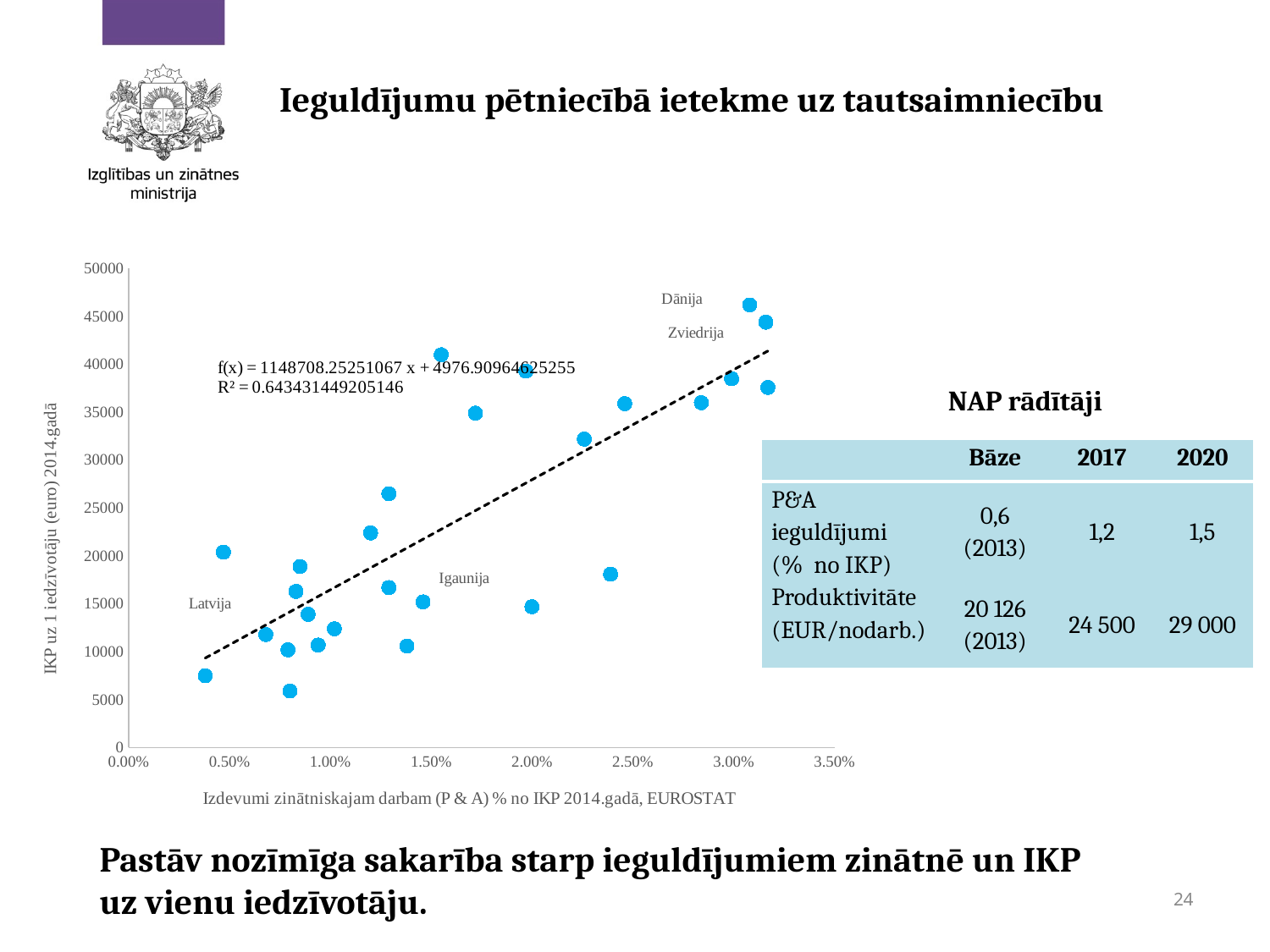
What R² value is printed on the chart? R² = 0.643431449205146 Is the x-axis value for Igaunija greater or less than 2.00%? less What kind of chart is shown on the slide? scatter chart What is the label of the y axis of the chart? IKP uz 1 iedzīvotāju (euro) 2014.gadā Is the value for Igaunija on the y axis greater or less than 20000? less Which labelled country has the highest GDP per capita in the chart? Dānija Is the value for Dānija on the y axis greater or less than 40000? greater Which has a higher GDP per capita, Dānija or Igaunija? Dānija Do the plotted values generally rise or fall as the x-axis value (P&A expenditure % of GDP) increases? rise